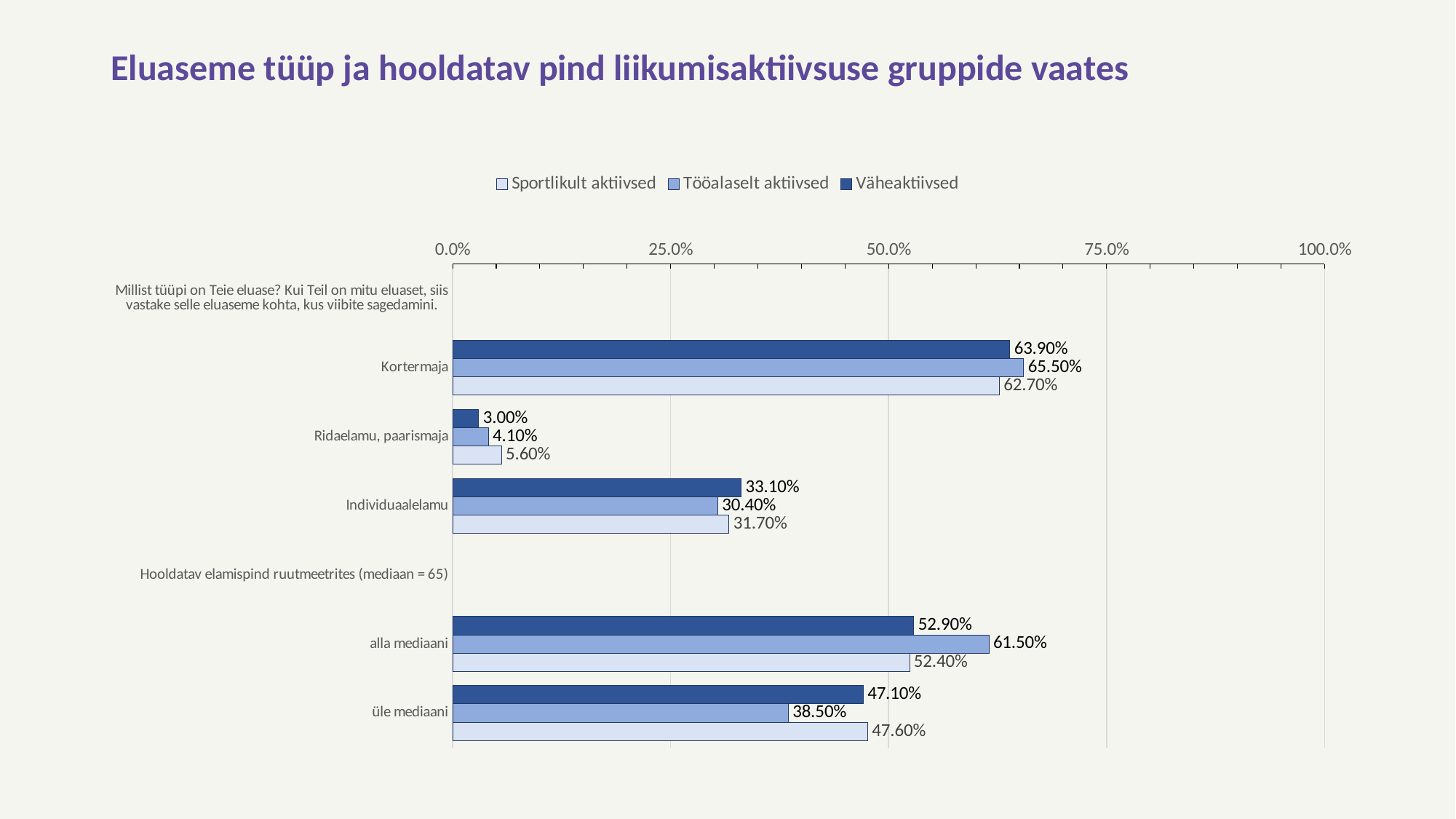
What is the value for Tööalaselt aktiivsed in the üle mediaani category? 38.50% Is the Sportlikult aktiivsed value for üle mediaani greater or less than 50.0%? less Which series has the highest value in the Kortermaja category? Tööalaselt aktiivsed What is the value for Sportlikult aktiivsed in the Ridaelamu, paarismaja category? 5.60% What is the difference between the Tööalaselt aktiivsed and Väheaktiivsed values in the alla mediaani category? 8.60% What is the title of the chart? Eluaseme tüüp ja hooldatav pind liikumisaktiivsuse gruppide vaates Which housing type category has the lowest value for Väheaktiivsed? Ridaelamu, paarismaja What kind of chart is shown on the slide? Bar chart How many series does the legend list? 3 What is the value for Väheaktiivsed in the Kortermaja category? 63.90% What is the value for Tööalaselt aktiivsed in the alla mediaani category? 61.50% In the Individuaalelamu category, which is larger: the Väheaktiivsed value or the Tööalaselt aktiivsed value? Väheaktiivsed